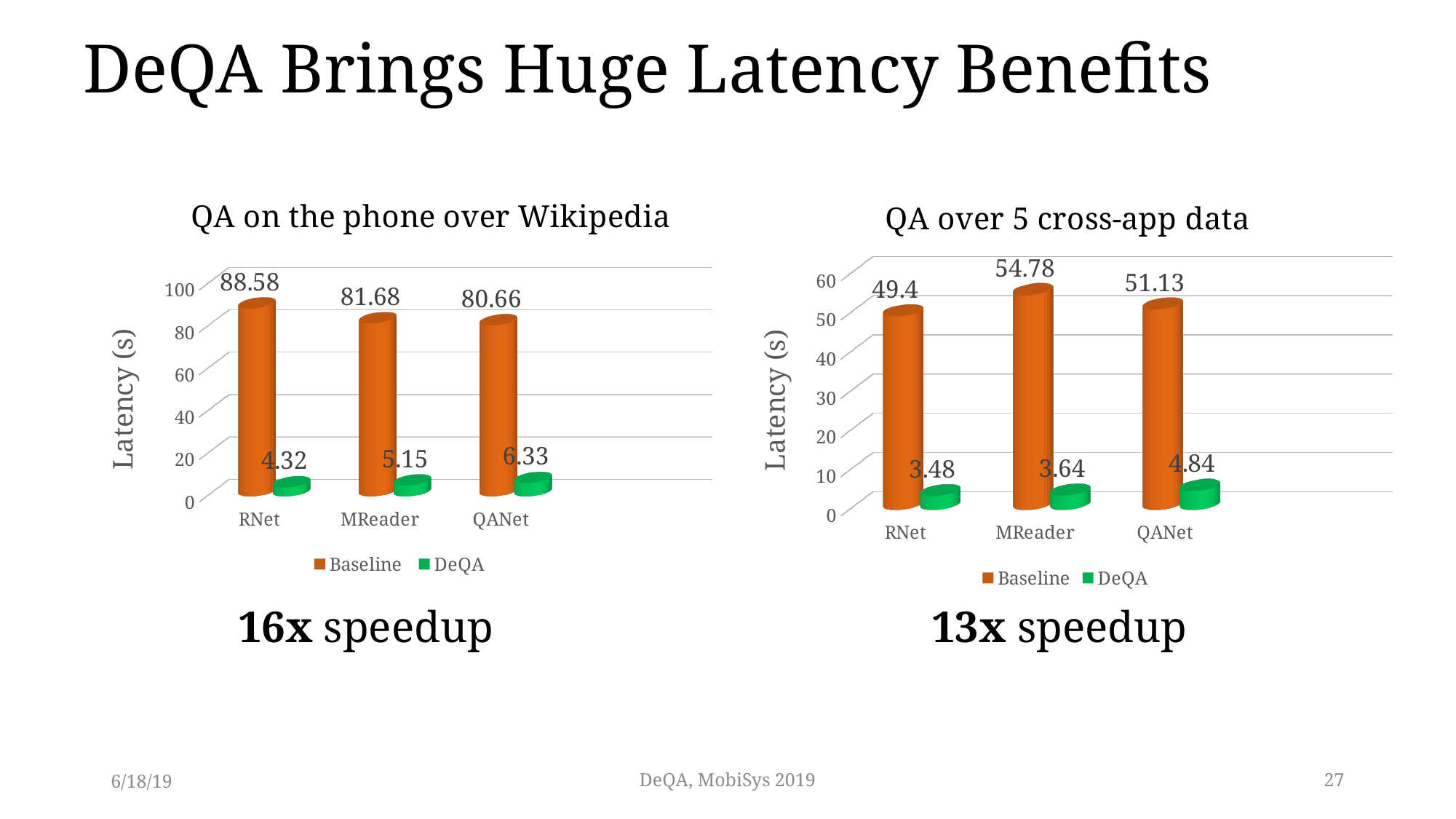
In the 'QA on the phone over Wikipedia' chart, what is the DeQA latency for QANet? 6.33 In the 'QA over 5 cross-app data' chart, which is larger: the Baseline latency for QANet or for RNet? QANet In the 'QA on the phone over Wikipedia' chart, which model has the highest Baseline latency? RNet How many models are compared in the 'QA on the phone over Wikipedia' chart? 3 What is the y-axis label of the 'QA over 5 cross-app data' chart? Latency (s) In the 'QA over 5 cross-app data' chart, which model has the lowest DeQA latency? RNet In the 'QA on the phone over Wikipedia' chart, what is the difference between the Baseline and DeQA latency for MReader? 76.53 In the 'QA on the phone over Wikipedia' chart, what is the Baseline latency for RNet? 88.58 How many series does the legend of the 'QA over 5 cross-app data' chart list? 2 What type of chart is the 'QA on the phone over Wikipedia' chart? Bar chart In the 'QA over 5 cross-app data' chart, what is the DeQA latency for RNet? 3.48 In the 'QA over 5 cross-app data' chart, what is the Baseline latency for MReader? 54.78